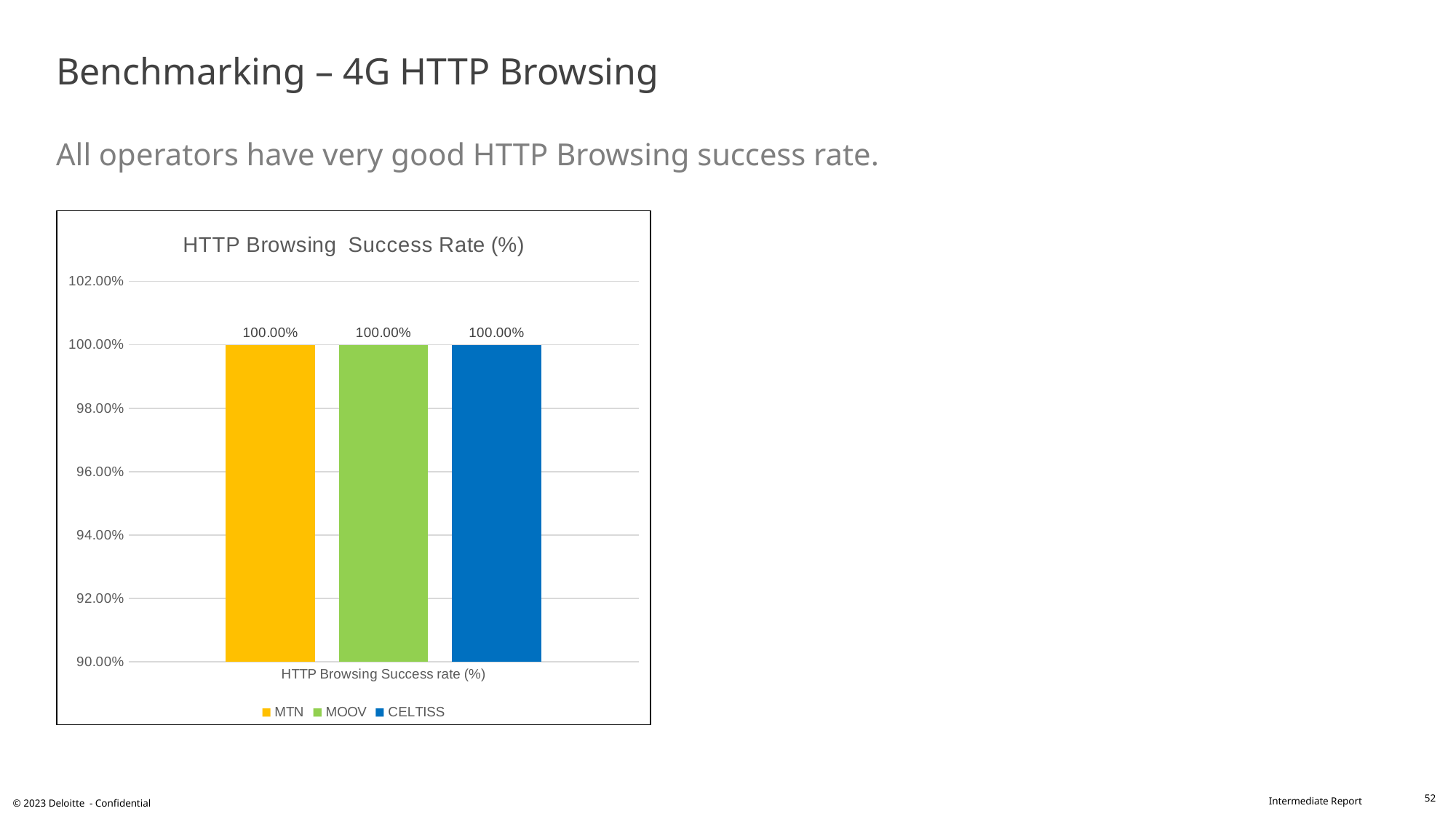
How many series does the legend list? 3 Which operator is represented by the blue bar? CELTISS What is the HTTP Browsing success rate for MOOV? 100.00% What is the HTTP Browsing success rate for MTN? 100.00% What is the difference between the MTN and CELTISS HTTP Browsing success rates? 0.00% What is the title of the chart? HTTP Browsing Success Rate (%) What kind of chart is shown on the slide? bar chart Is the HTTP Browsing success rate for MOOV greater or less than 98.00%? greater What is the HTTP Browsing success rate for CELTISS? 100.00% How many bars are plotted in the chart? 3 What is the lowest value shown on the vertical axis? 90.00%